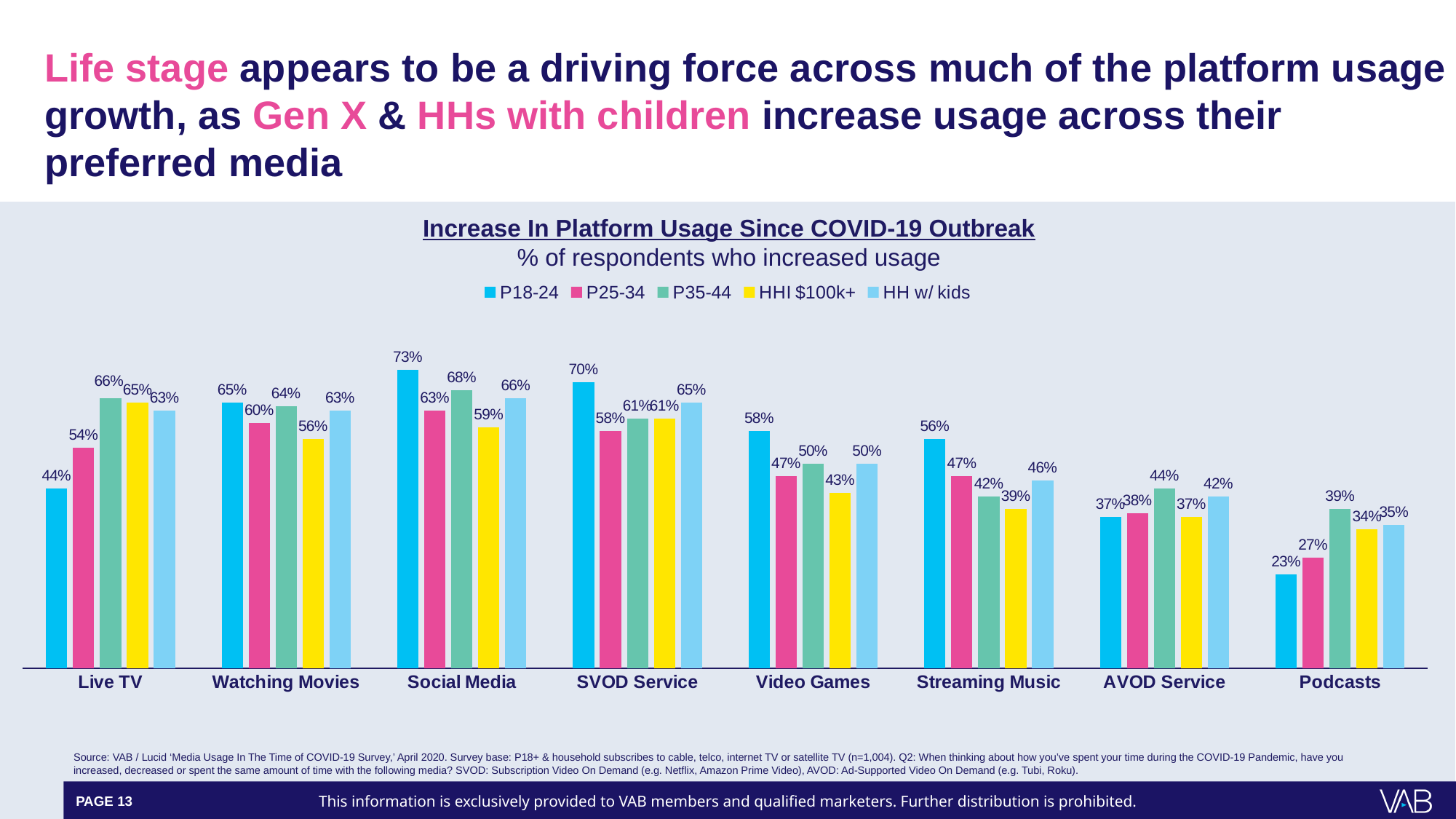
Which platform has the lowest value for the P18-24 series? Podcasts What is the difference between the P18-24 and P25-34 values for Live TV? 10% How many series does the legend list? 5 How many platform categories are shown on the x axis? 8 What is the value for HHI $100k+ for Video Games? 43% For Streaming Music, which is larger: the P18-24 value or the HH w/ kids value? P18-24 What is the value for HH w/ kids for Podcasts? 35% What is the title of the chart? Increase In Platform Usage Since COVID-19 Outbreak What kind of chart is shown on the slide? Bar chart What percentage of P18-24 respondents increased usage of Social Media? 73% Which series is shown in yellow in the legend? HHI $100k+ Which platform has the highest value for the P35-44 series? Social Media